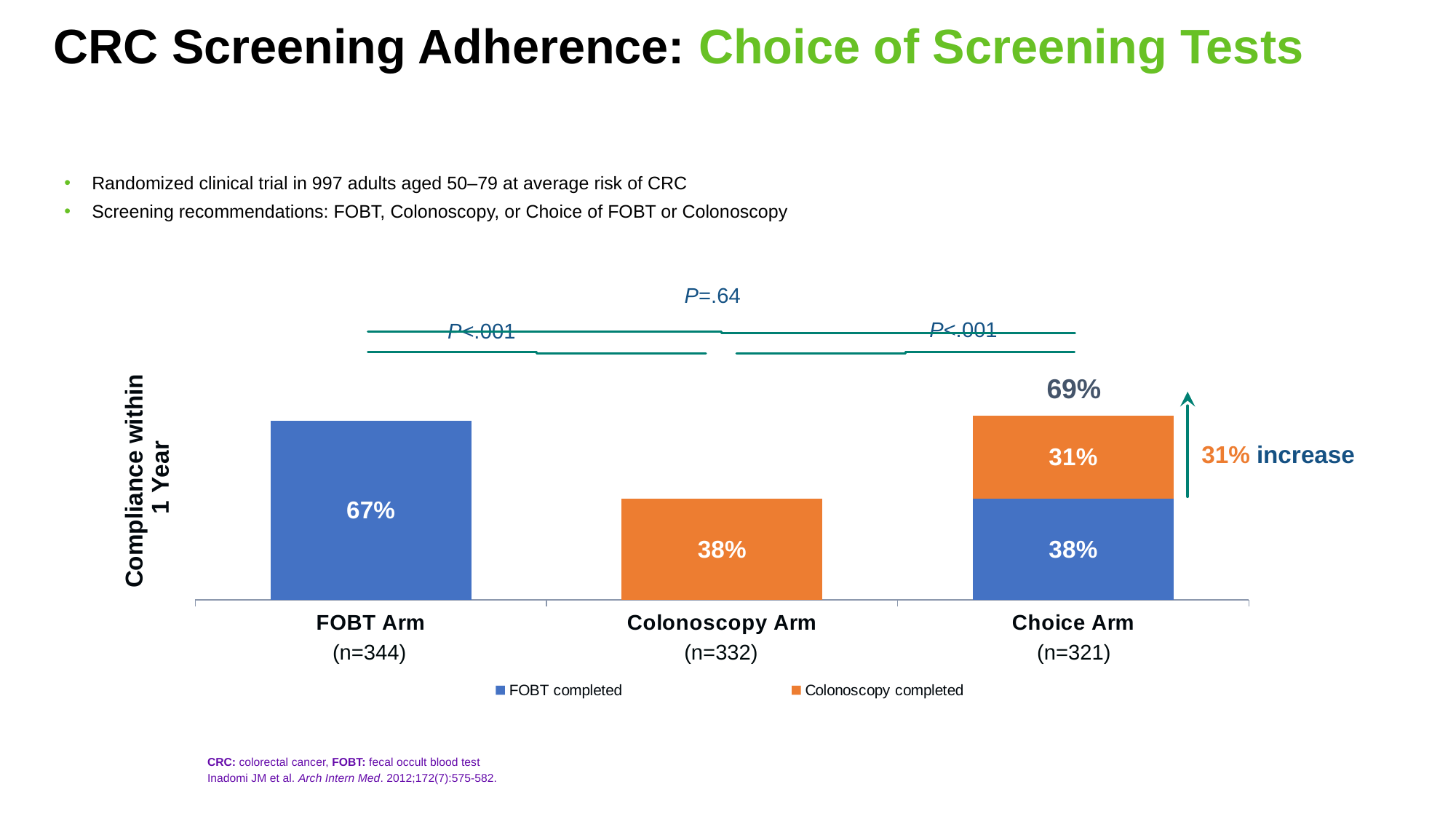
What is the Colonoscopy completed value for the Choice Arm? 31% What kind of chart is shown on the slide? Stacked bar chart Which is larger: the FOBT completed value in the FOBT Arm or the FOBT completed value in the Choice Arm? FOBT Arm How many series does the legend list? 2 What is the FOBT completed value for the FOBT Arm? 67% Which arm has the highest total compliance within 1 year? Choice Arm Which arm has the lowest total compliance within 1 year? Colonoscopy Arm What is the total compliance shown for the Choice Arm? 69% What is the Colonoscopy completed value for the Colonoscopy Arm? 38% What is the FOBT completed value for the Choice Arm? 38% How many arms (categories) are shown on the x axis? 3 What is the difference between the FOBT Arm compliance and the Colonoscopy Arm compliance? 29%